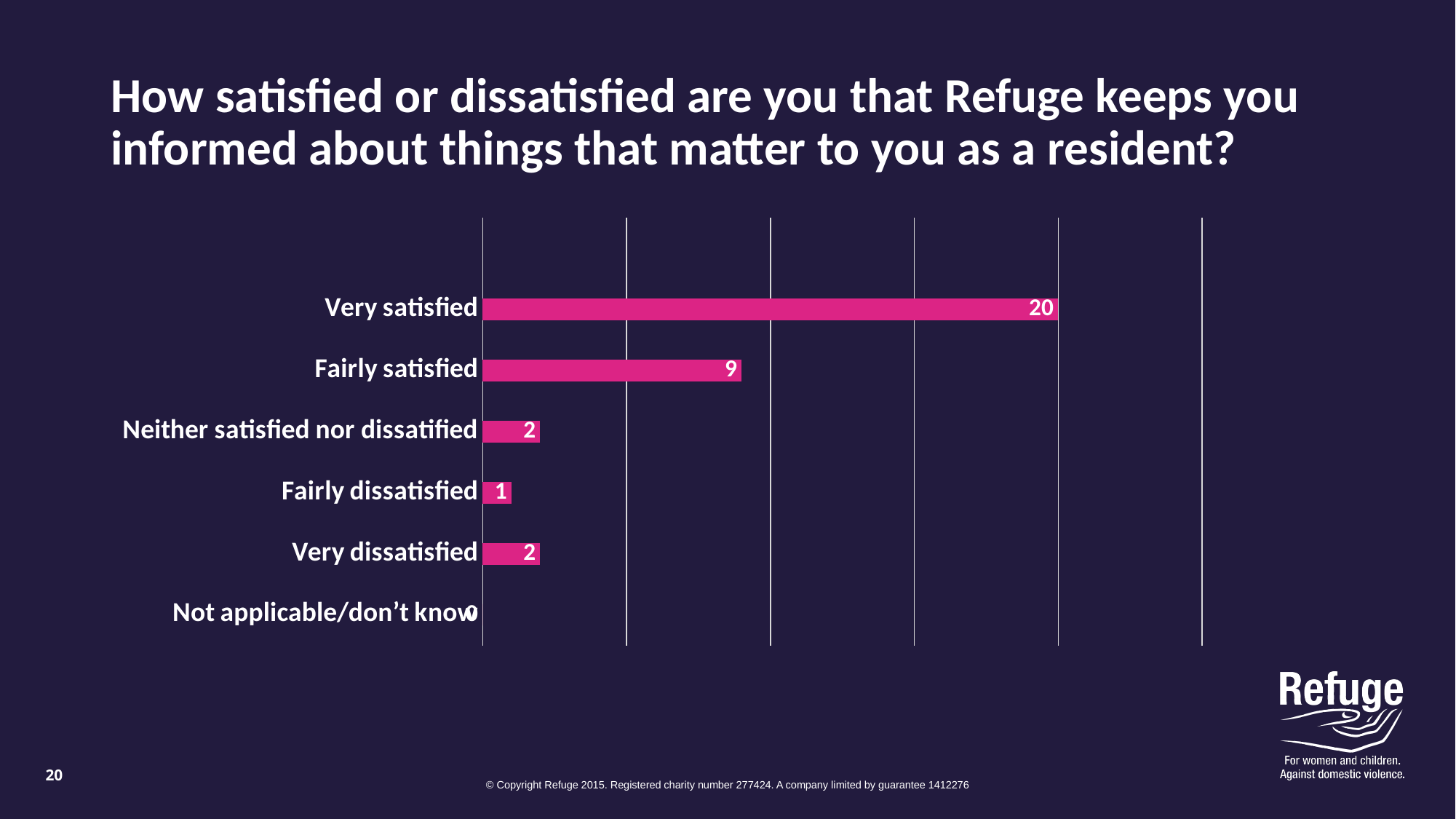
What kind of chart is shown on the slide? Bar chart What is the value for Fairly dissatisfied? 1 What is the value for Very satisfied? 20 What colour are the bars in the chart? Pink Which category has the highest value? Very satisfied What is the difference between the values for Very satisfied and Fairly satisfied? 11 Which category has the lowest value? Not applicable/don't know What is the value for Not applicable/don't know? 0 What is the value for Fairly satisfied? 9 How many categories are shown in the chart? 6 What is the value for Neither satisfied nor dissatisfied? 2 Which is larger, the value for Fairly dissatisfied or the value for Very dissatisfied? Very dissatisfied